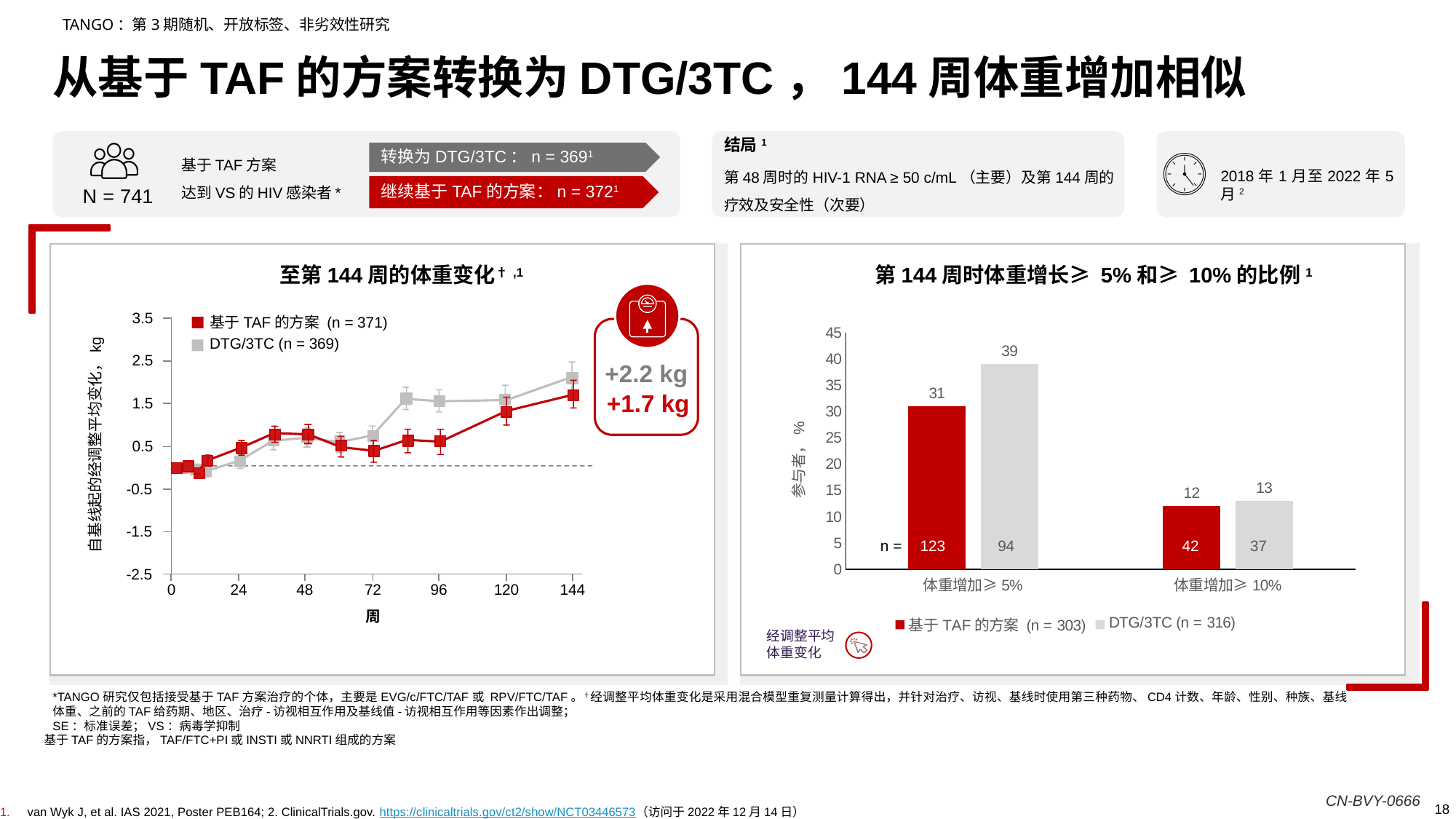
In the right chart (第 144 周时体重增长≥ 5% 和≥ 10% 的比例), what is the value for DTG/3TC in the 体重增加≥ 5% category? 39 In the left chart (至第 144 周的体重变化), what is the weight change for DTG/3TC at week 144 as shown in the callout? +2.2 kg In the right chart (第 144 周时体重增长≥ 5% 和≥ 10% 的比例), how many series does the legend list? 2 In the right chart (第 144 周时体重增长≥ 5% 和≥ 10% 的比例), what is the value for 基于 TAF 的方案 in the 体重增加≥ 10% category? 12 In the right chart (第 144 周时体重增长≥ 5% 和≥ 10% 的比例), is the value for 基于 TAF 的方案 in the 体重增加≥ 5% category greater or less than 30? greater In the right chart (第 144 周时体重增长≥ 5% 和≥ 10% 的比例), what is the difference between the DTG/3TC and 基于 TAF 的方案 values in the 体重增加≥ 5% category? 8 In the left chart (至第 144 周的体重变化), what is the weight change for 基于 TAF 的方案 at week 144 as shown in the callout? +1.7 kg What kind of chart is the left chart (至第 144 周的体重变化)? line chart In the right chart (第 144 周时体重增长≥ 5% 和≥ 10% 的比例), which bar is the lowest? 基于 TAF 的方案, 体重增加≥ 10% In the left chart (至第 144 周的体重变化), do the values for DTG/3TC generally rise or fall from week 0 to week 144? rise What kind of chart is the right chart (第 144 周时体重增长≥ 5% 和≥ 10% 的比例)? bar chart In the right chart (第 144 周时体重增长≥ 5% 和≥ 10% 的比例), which bar is the highest? DTG/3TC, 体重增加≥ 5%